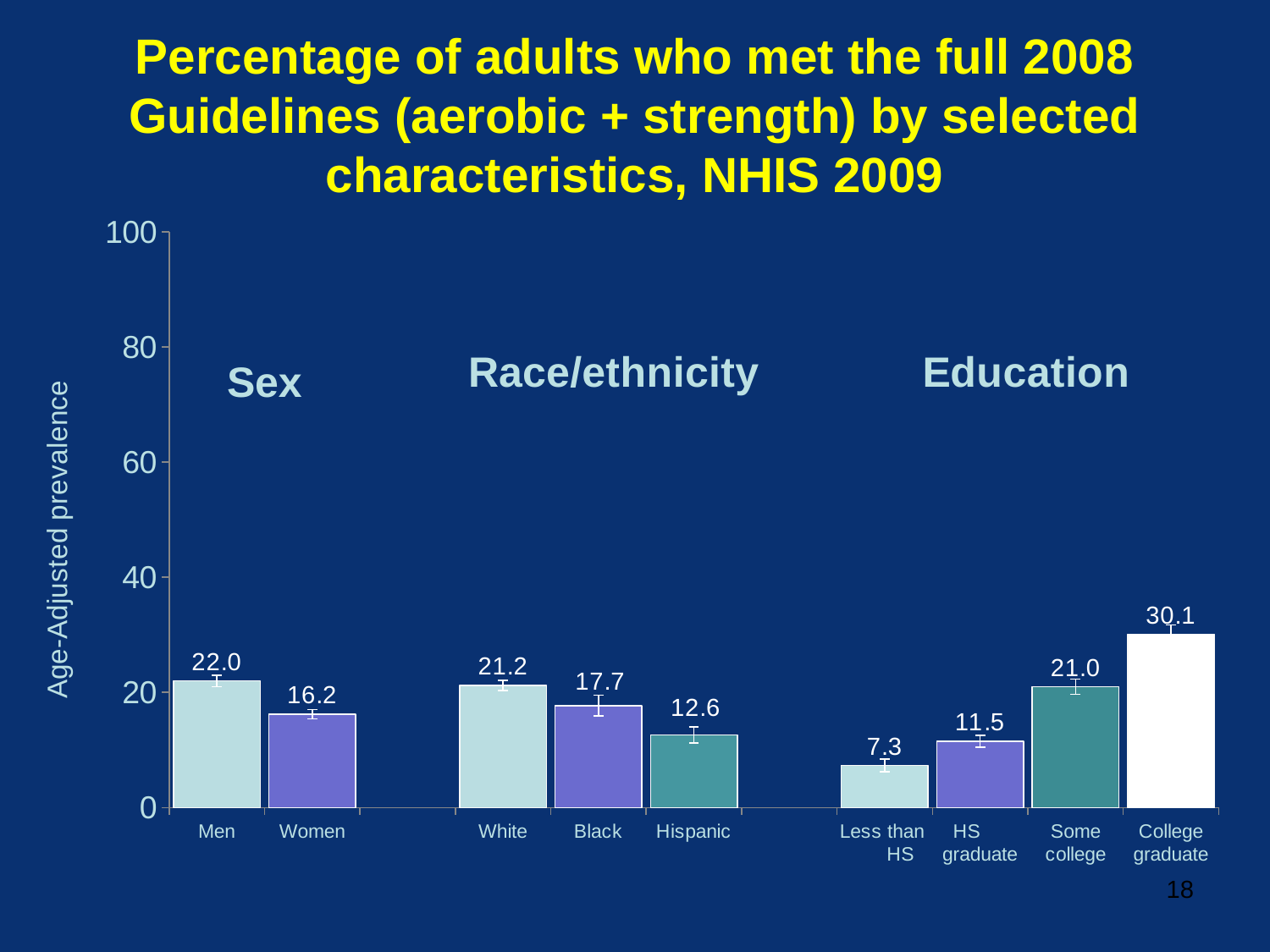
What is the difference between the values for Men and Women? 5.8 Which category has the lowest value on the chart? Less than HS What is the label of the vertical axis? Age-Adjusted prevalence What is the difference between the values for College graduate and Less than HS? 22.8 What is the value shown for College graduate? 30.1 Which category has the highest value on the chart? College graduate What is the age-adjusted prevalence for Men? 22.0 What kind of chart is shown on the slide? bar chart Which has a larger value, White or Black? White What is the age-adjusted prevalence for Hispanic adults? 12.6 Is the value for HS graduate greater or less than 20? less How many categories are plotted on the chart? 9